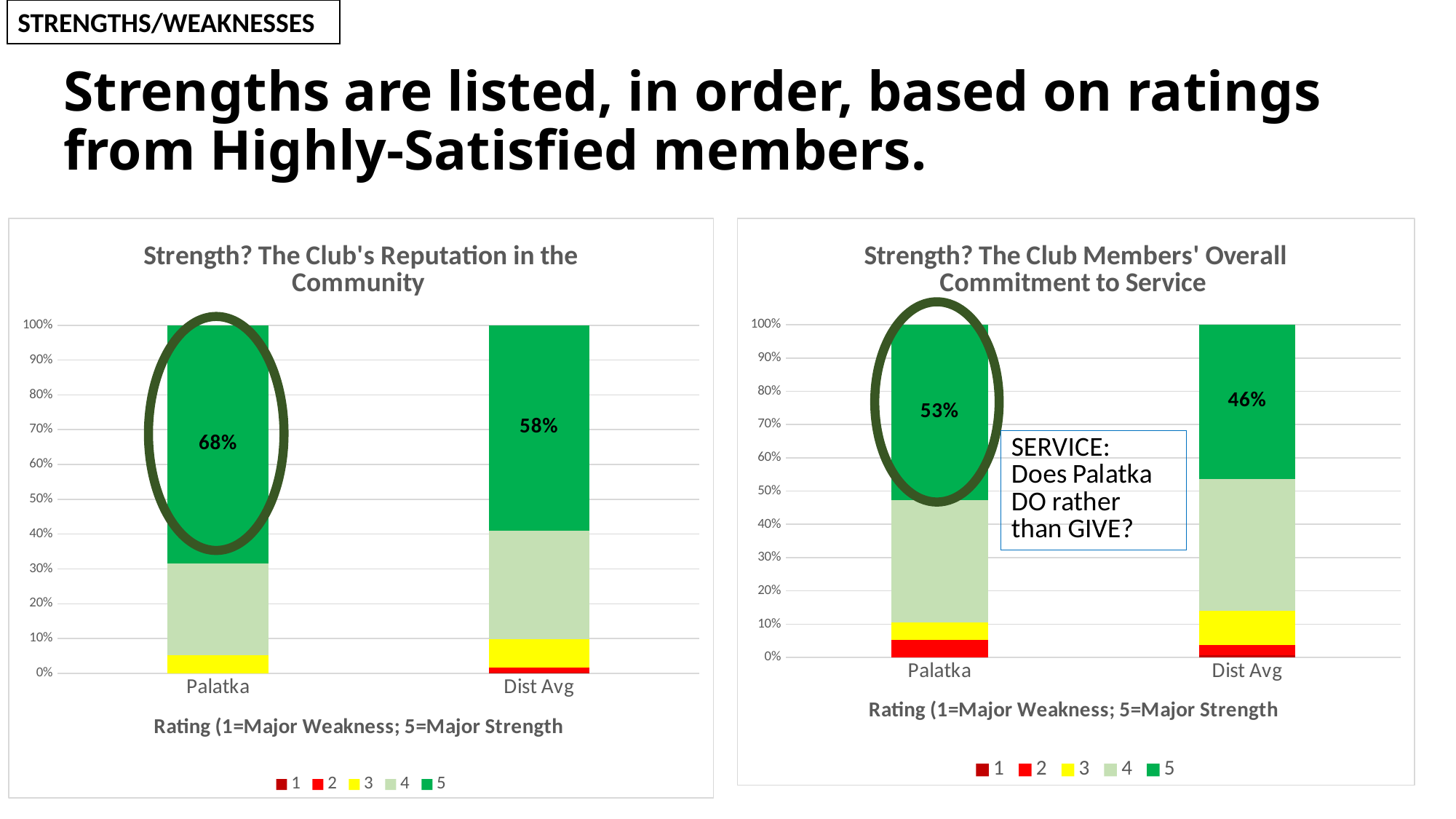
In the left chart, is the rating-4 share for Dist Avg greater or less than 20%? greater How many categories are shown on the x axis of the left chart? 2 In the right chart, which has the larger rating-5 share, Palatka or Dist Avg? Palatka In the left chart, which has the larger rating-5 share, Palatka or Dist Avg? Palatka In the chart titled "Strength? The Club Members' Overall Commitment to Service", what percentage of Dist Avg ratings are a 5? 46% How many series does the legend of the right chart list? 5 In the right chart, what is the difference between the rating-5 share for Palatka and for Dist Avg? 7% In the chart titled "Strength? The Club Members' Overall Commitment to Service", what percentage of Palatka ratings are a 5? 53% In the chart titled "Strength? The Club's Reputation in the Community", what percentage of Palatka ratings are a 5? 68% In the chart titled "Strength? The Club's Reputation in the Community", what percentage of Dist Avg ratings are a 5? 58% In the left chart, how much larger is the rating-5 share for Palatka than for Dist Avg? 10% What type of chart is the chart titled "Strength? The Club Members' Overall Commitment to Service"? Stacked bar chart